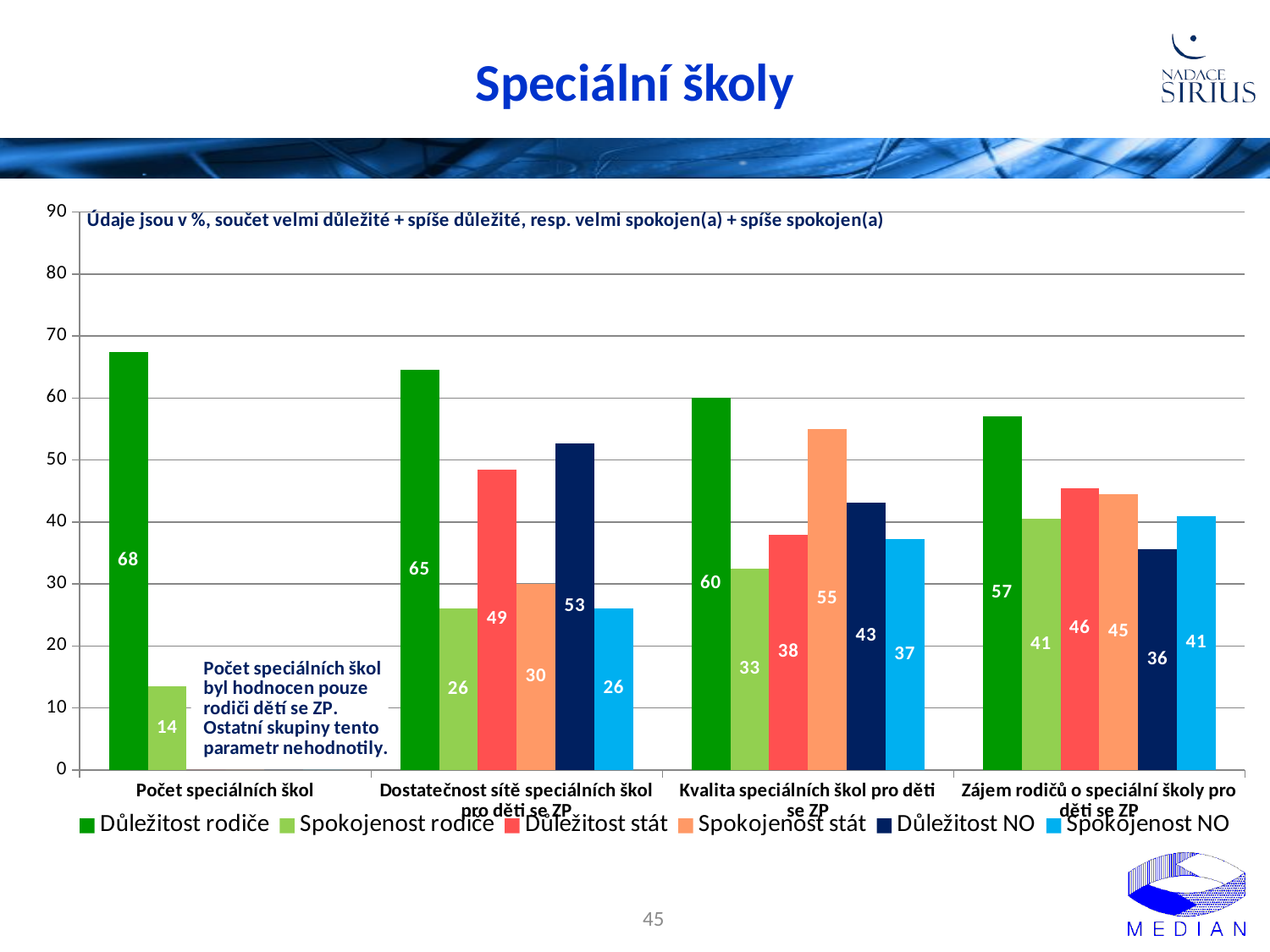
What is the value for Důležitost NO in the category Dostatečnost sítě speciálních škol pro děti se ZP? 53 In which category is the Důležitost rodiče value highest? Počet speciálních škol What is the value for Spokojenost stát in the category Kvalita speciálních škol pro děti se ZP? 55 How many series does the legend list? 6 What is the value for Důležitost rodiče in the category Počet speciálních škol? 68 In which category is the Spokojenost rodiče value lowest? Počet speciálních škol Is the value for Důležitost rodiče in the category Zájem rodičů o speciální školy pro děti se ZP greater or less than 50? greater Do the Důležitost rodiče values rise or fall from left to right across the categories? fall What is the difference between Důležitost rodiče and Spokojenost rodiče in the category Počet speciálních škol? 54 How many categories are shown on the x axis of the chart? 4 In the category Kvalita speciálních škol pro děti se ZP, which is larger: Důležitost stát or Spokojenost stát? Spokojenost stát What kind of chart is shown on the slide? bar chart